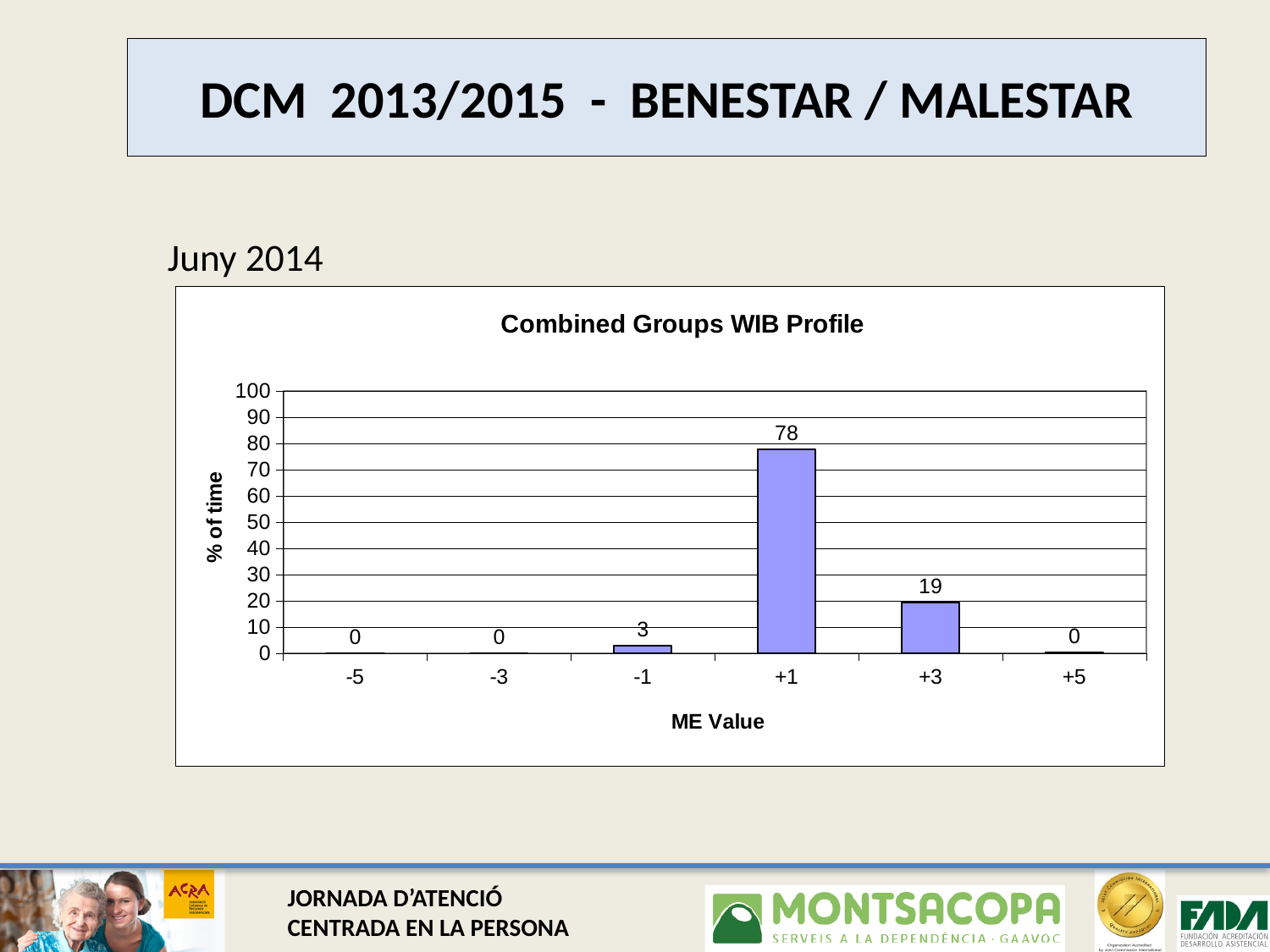
How many ME Value categories are shown on the x axis? 6 Which is larger, the value for -1 or the value for +3? +3 What kind of chart is shown? bar chart What is the value for ME Value +3? 19 What is the title of the chart? Combined Groups WIB Profile What is the value for ME Value +1? 78 What is the difference between the values for +1 and +3? 59 Which ME Value has the highest percentage of time? +1 What is the value for ME Value -1? 3 What is the label of the y axis? % of time What is the value for ME Value +5? 0 Is the value for +1 greater or less than 70? greater